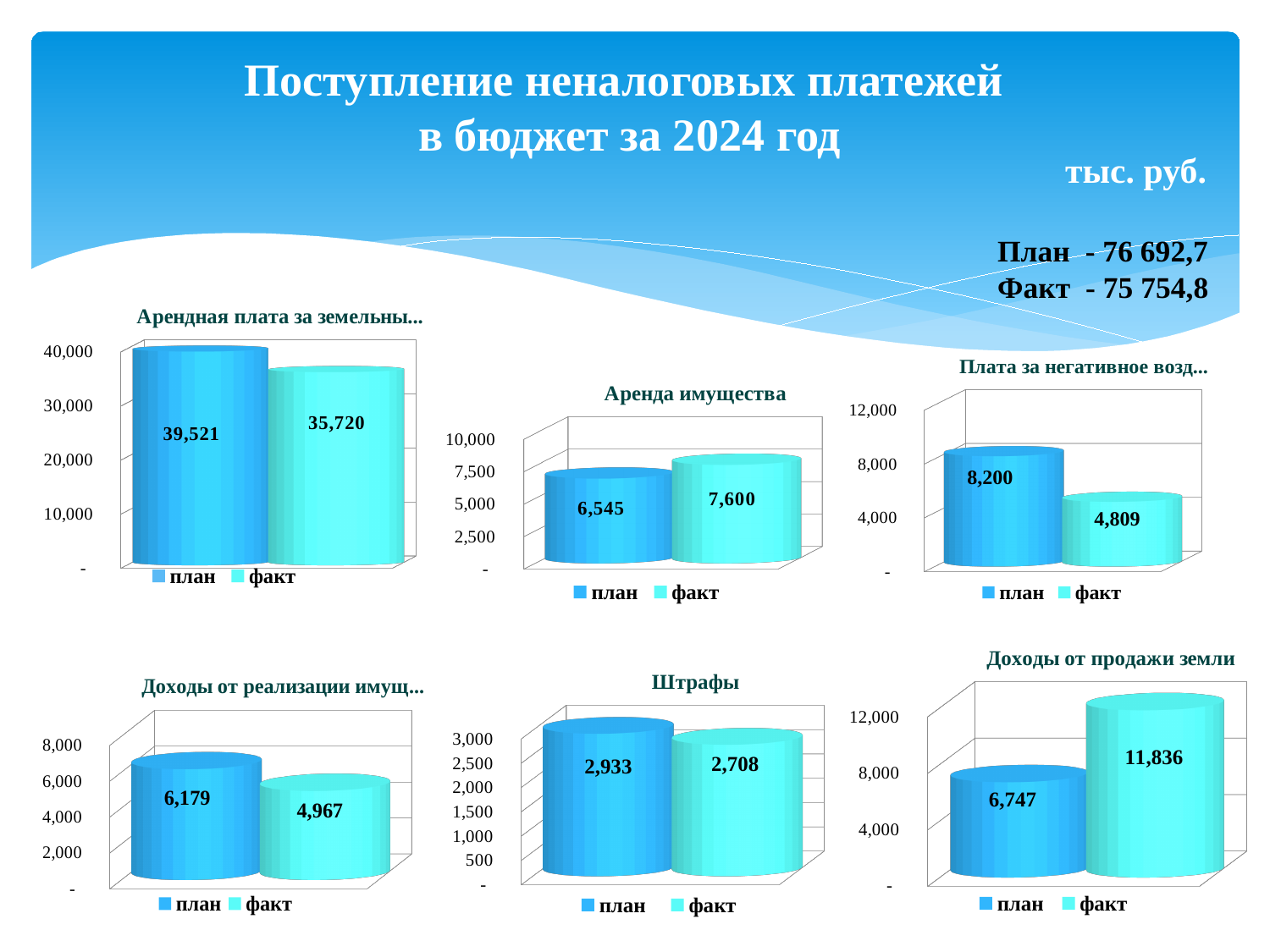
How many charts are shown on the slide? 6 In the 'Доходы от продажи земли' chart, what is the difference between факт and план? 5,089 In the 'Аренда имущества' chart, what is the value for план? 6,545 In the 'Штрафы' chart, what is the value for факт? 2,708 What kind of chart is 'Доходы от продажи земли'? bar chart In the 'Доходы от продажи земли' chart, what is the value for план? 6,747 In the 'Штрафы' chart, which is larger, план or факт? план In the 'Аренда имущества' chart, what is the value for факт? 7,600 In the top-left chart (Арендная плата за земельны...), what is the difference between план and факт? 3,801 How many series does the legend of the 'Штрафы' chart list? 2 In the top-right chart (Плата за негативное возд...), which bar is the lowest? факт In the bottom-left chart (Доходы от реализации имущ...), what is the value for факт? 4,967